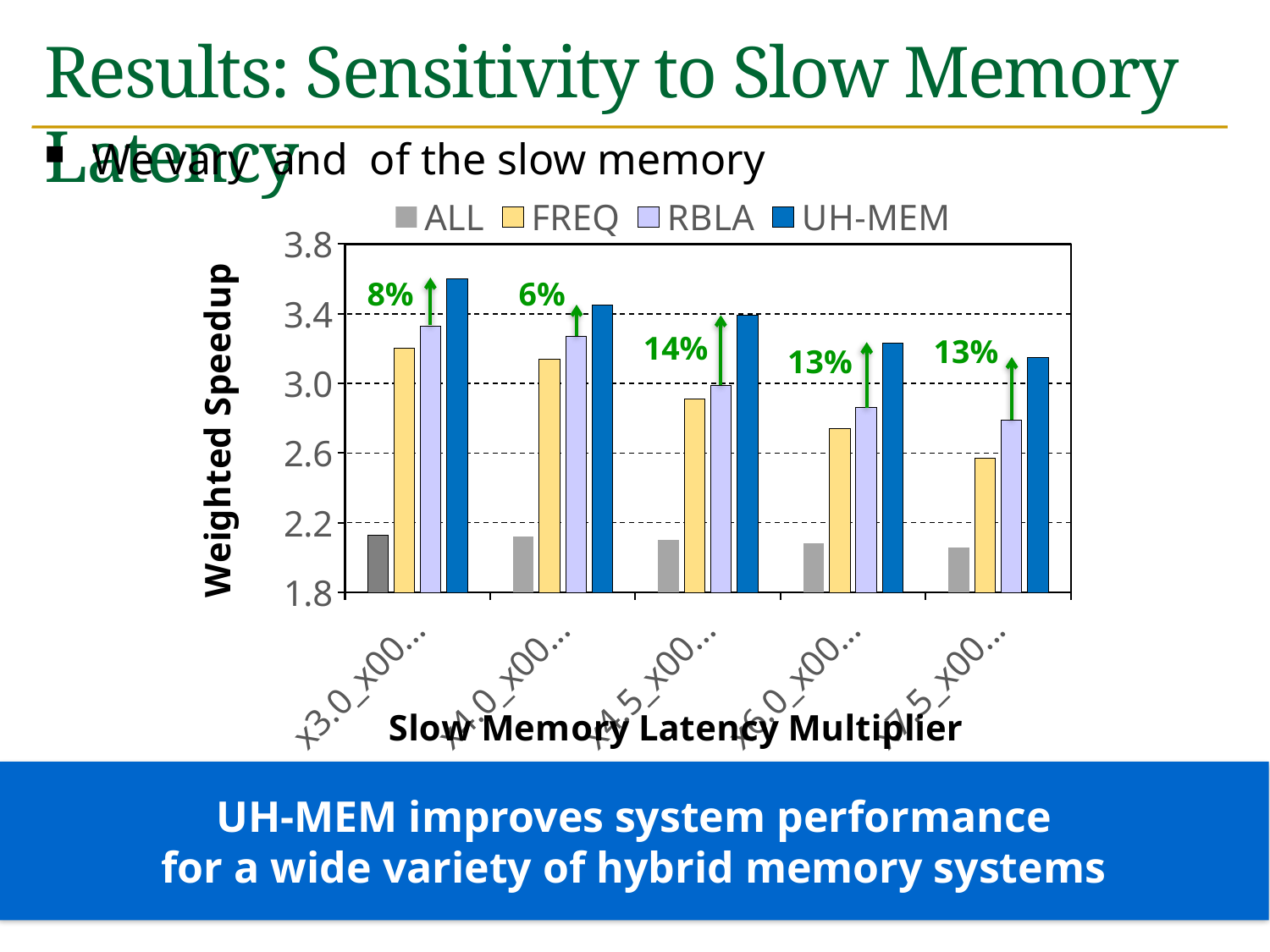
Is the FREQ value in the fourth group greater or less than 2.6? greater What are the four series named in the legend? ALL, FREQ, RBLA, UH-MEM What kind of chart is shown on the slide? bar chart Which series has the shortest bar in every group? ALL Do the UH-MEM values rise or fall as the slow memory latency multiplier increases along the x axis? fall Is the UH-MEM value in the first (leftmost) group greater or less than 3.4? greater How many series does the legend list? 4 How many categories are plotted along the x axis? 5 What is the title of the y axis? Weighted Speedup What percentage improvement is annotated above the first (leftmost) group of bars? 8% What percentage improvement is annotated above the third group of bars? 14% Which series has the tallest bar in every group? UH-MEM